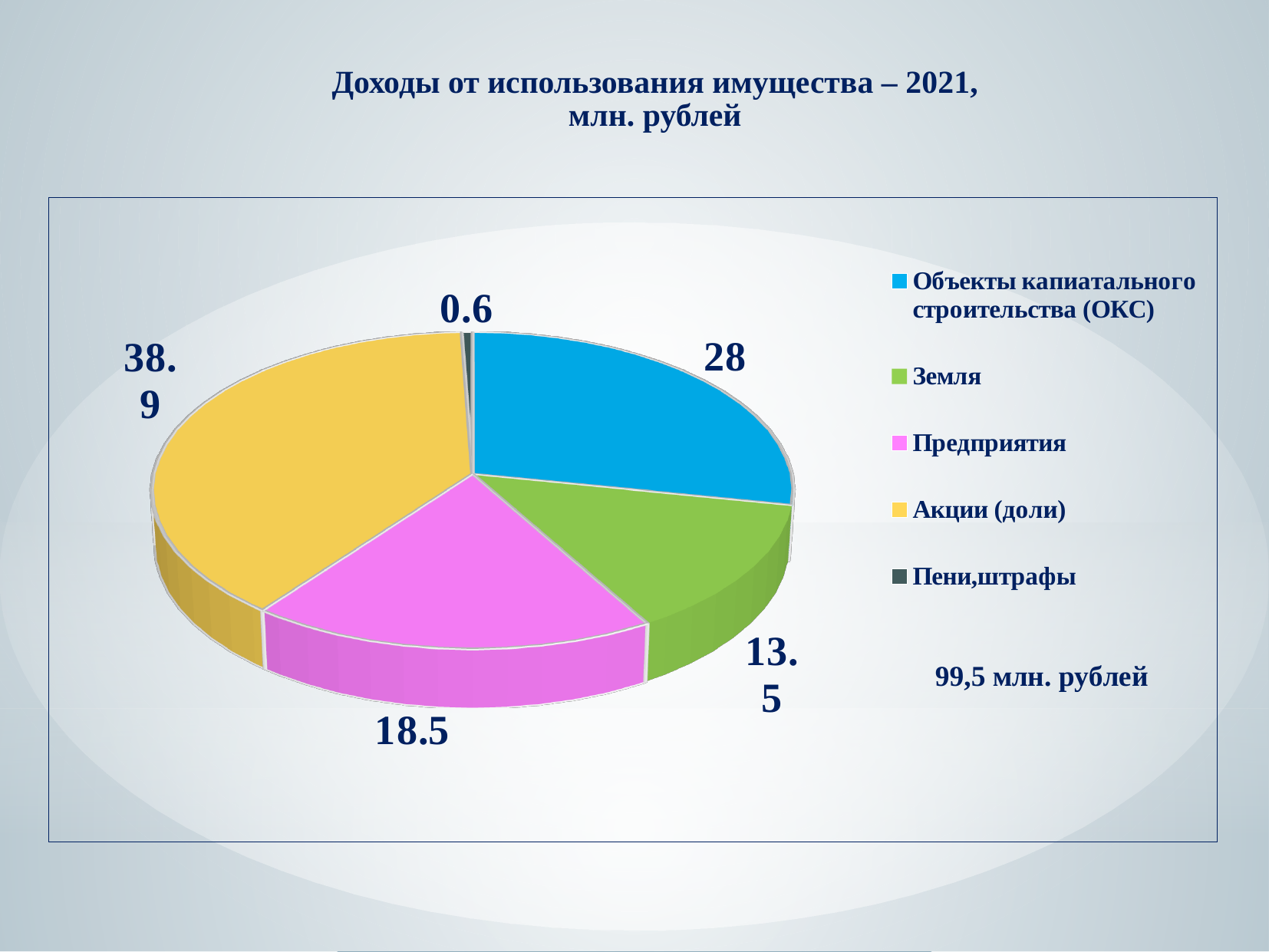
What kind of chart is shown on the slide? Pie chart What is the value for Земля? 13.5 How many categories does the pie chart show? 5 What is the value for Объекты капиатального строительства (ОКС)? 28 What is the difference between the values for Акции (доли) and Объекты капиатального строительства (ОКС)? 10.9 What is the value for Пени,штрафы? 0.6 What is the value for Предприятия? 18.5 Which category has the smallest slice of the pie? Пени,штрафы Which category has the largest slice of the pie? Акции (доли) What is the value for Акции (доли)? 38.9 Which is larger, the value for Предприятия or the value for Земля? Предприятия What total amount in млн. рублей is printed next to the chart? 99,5 млн. рублей